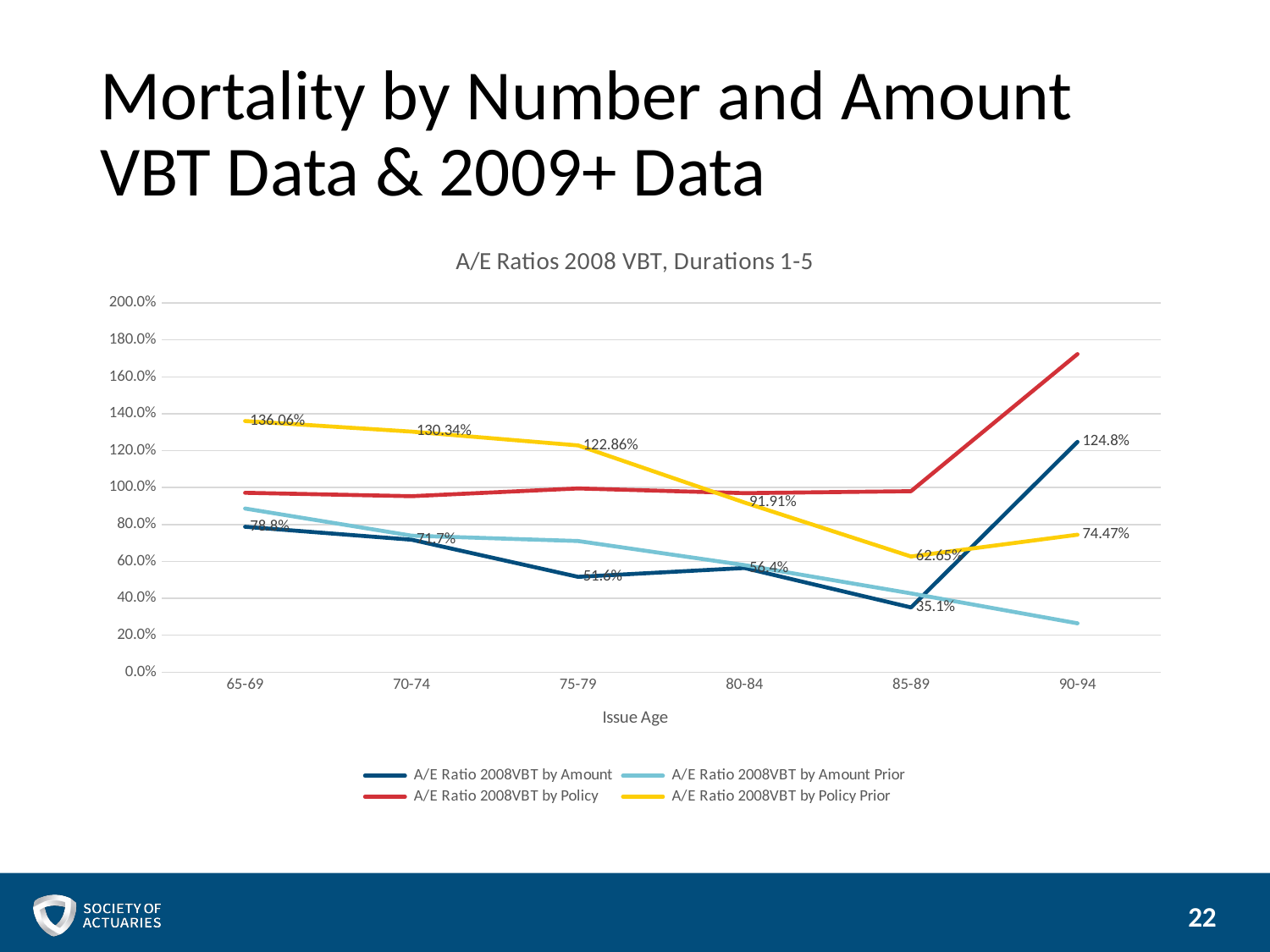
For which issue age is the A/E Ratio 2008VBT by Policy Prior lowest? 85-89 How many series does the legend list? 4 What is the A/E Ratio 2008VBT by Amount for issue age 85-89? 35.1% For which issue age is the A/E Ratio 2008VBT by Amount highest? 90-94 At issue age 80-84, which is larger: the A/E Ratio 2008VBT by Policy Prior or the A/E Ratio 2008VBT by Amount? A/E Ratio 2008VBT by Policy Prior What is the A/E Ratio 2008VBT by Policy Prior for issue age 80-84? 91.91% What is the A/E Ratio 2008VBT by Amount for issue age 90-94? 124.8% How many issue age groups are shown on the x axis? 6 What is the A/E Ratio 2008VBT by Policy Prior for issue age 65-69? 136.06% What is the difference between the A/E Ratio 2008VBT by Policy Prior at issue age 65-69 and at issue age 90-94? 61.59% Is the A/E Ratio 2008VBT by Policy for issue age 90-94 greater or less than 160.0%? greater What kind of chart is shown on the slide? line chart